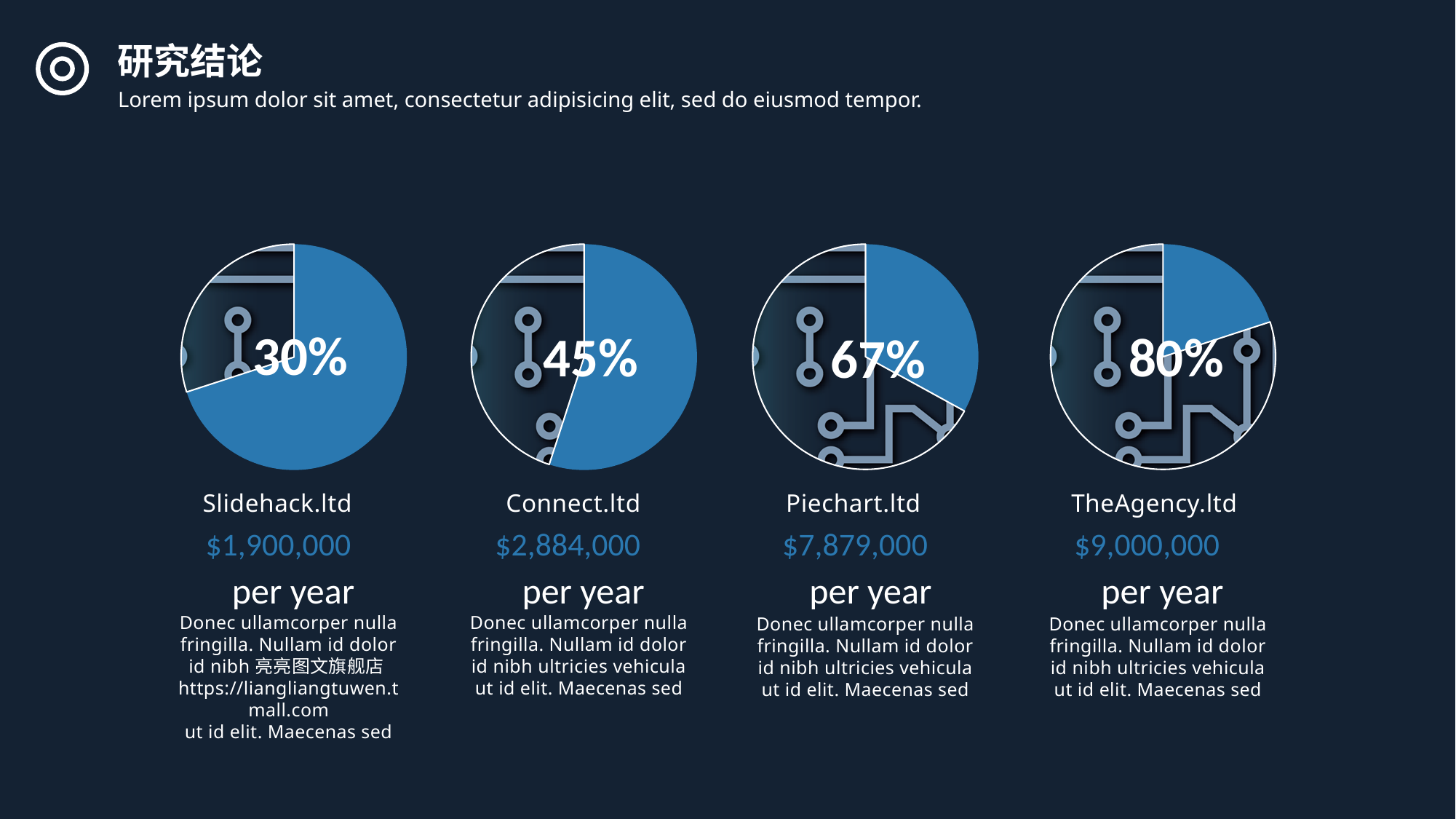
Which pie chart shows the lowest percentage? Slidehack.ltd What percentage is printed on the Connect.ltd pie chart? 45% What percentage is printed on the TheAgency.ltd pie chart? 80% What colour are the highlighted slices in the pie charts? Blue Which pie chart shows the highest percentage? TheAgency.ltd What percentage is printed on the Slidehack.ltd pie chart? 30% What is the difference between the percentages shown on the TheAgency.ltd and Slidehack.ltd pie charts? 50% What kind of charts are shown on the slide? Pie charts What yearly amount is listed under the Piechart.ltd pie chart? $7,879,000 What percentage is printed on the Piechart.ltd pie chart? 67% How many pie charts are on the slide? 4 Which shows a larger percentage, the Connect.ltd pie chart or the Piechart.ltd pie chart? Piechart.ltd